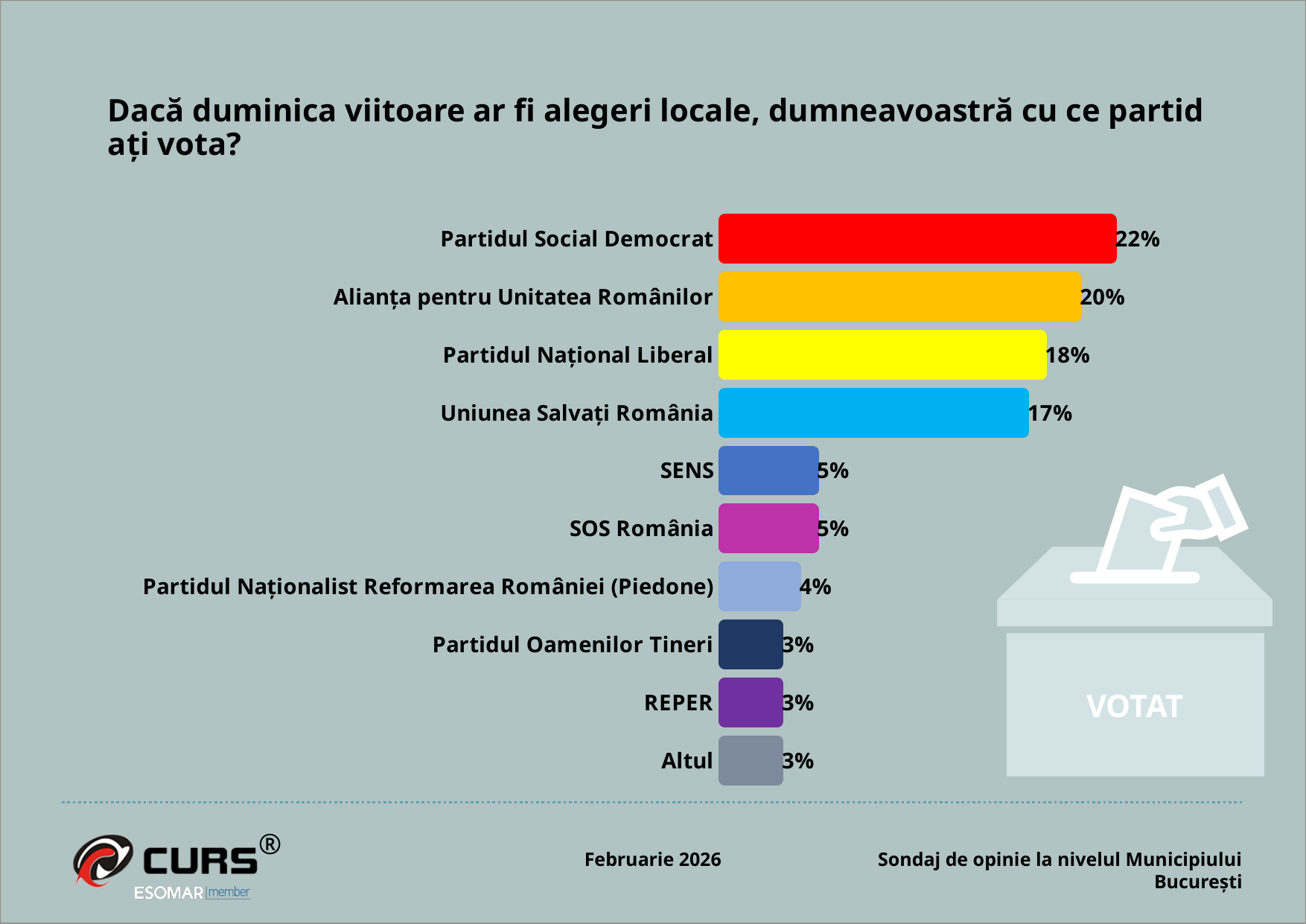
What kind of chart is shown on the slide? Bar chart What percentage of respondents would vote for Partidul Social Democrat? 22% Which has a larger value, Alianța pentru Unitatea Românilor or Partidul Național Liberal? Alianța pentru Unitatea Românilor What is the difference between Alianța pentru Unitatea Românilor and Uniunea Salvați România? 3 Which party has the highest percentage on the chart? Partidul Social Democrat What colour is the bar for Partidul Național Liberal? Yellow What is the difference in percentage points between Partidul Social Democrat and Partidul Național Liberal? 4 What value is shown for REPER? 3% What value is shown for Uniunea Salvați România? 17% Which has a larger value, SENS or Partidul Oamenilor Tineri? SENS What percentage is shown for Partidul Naționalist Reformarea României (Piedone)? 4% How many categories (parties/options) are shown on the chart? 10